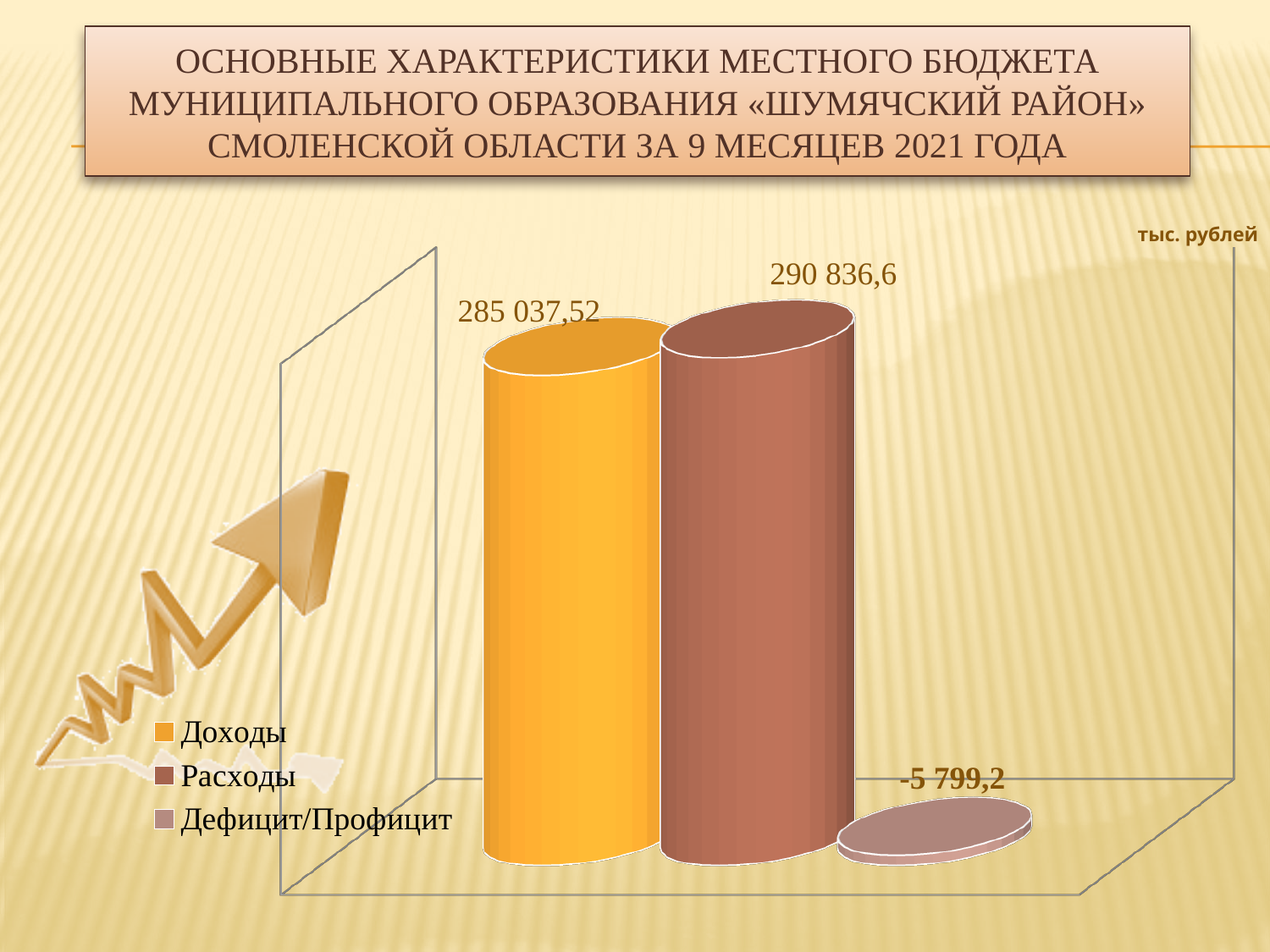
What is the value for Расходы? 290 836,6 What kind of chart is shown on the slide? Bar chart Which is larger, Доходы or Расходы? Расходы Which series has the highest value? Расходы What is the value for Дефицит/Профицит? -5 799,2 Which series has the lowest value? Дефицит/Профицит How many series does the legend list? 3 How many bars are plotted on the chart? 3 What is the value for Доходы? 285 037,52 Is the value for Доходы greater or less than the value for Расходы? less Which legend entry is shown in orange/yellow? Доходы What unit of measurement is indicated for the chart values? тыс. рублей